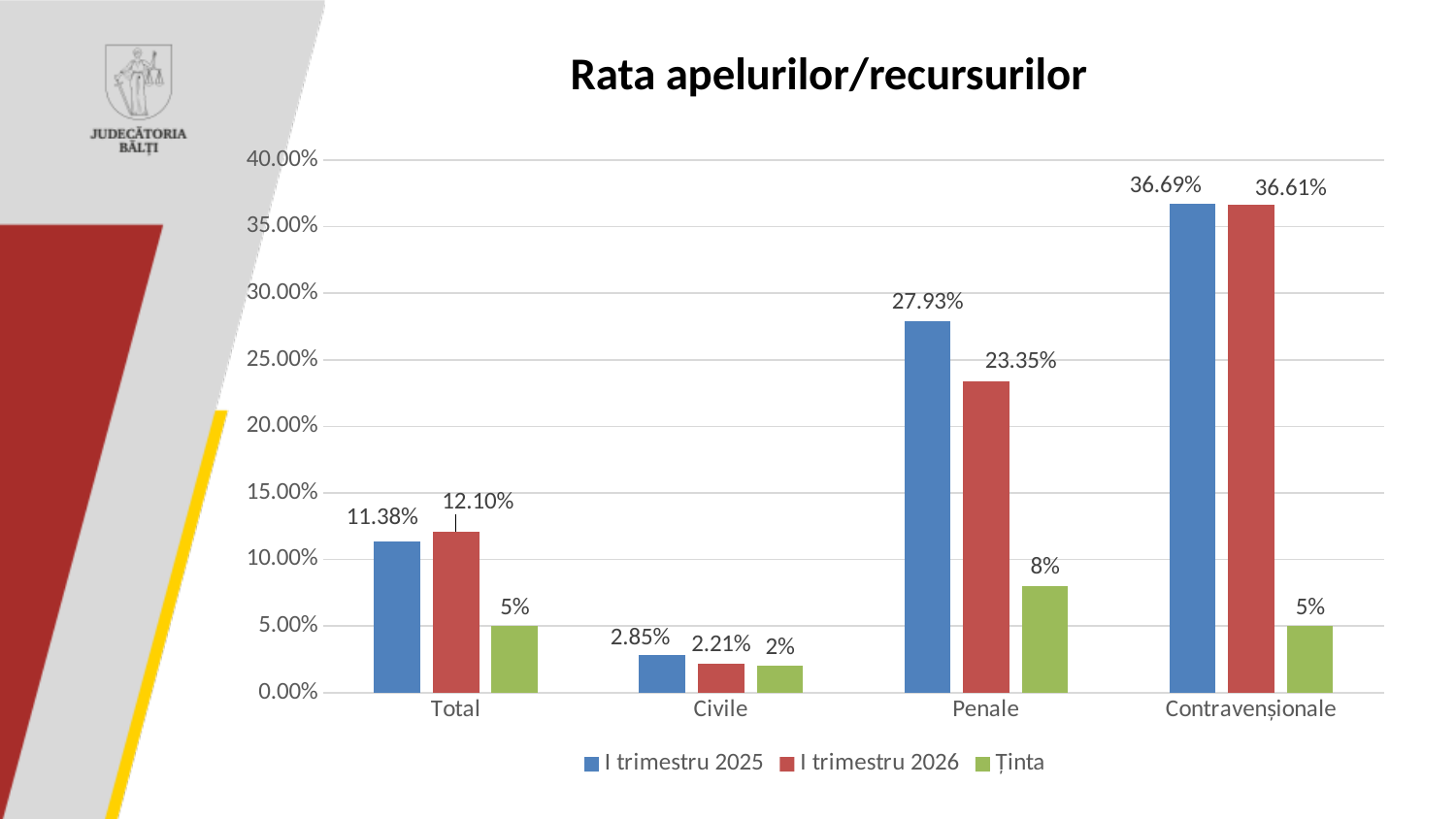
What is the value for Contravenționale in the I trimestru 2026 series? 36.61% Which category has the highest value in the I trimestru 2025 series? Contravenționale For Total, which is larger: the I trimestru 2025 value or the I trimestru 2026 value? I trimestru 2026 What kind of chart is shown on the slide? Bar chart How many categories are shown on the x axis? 4 What is the value for Penale in the I trimestru 2025 series? 27.93% Which category has the lowest value in the I trimestru 2026 series? Civile What is the difference between the I trimestru 2025 and I trimestru 2026 values for Penale? 4.58% How many series does the legend list? 3 What is the title of the chart? Rata apelurilor/recursurilor What is the Ținta value for Civile? 2% What is the value for Total in the I trimestru 2026 series? 12.10%